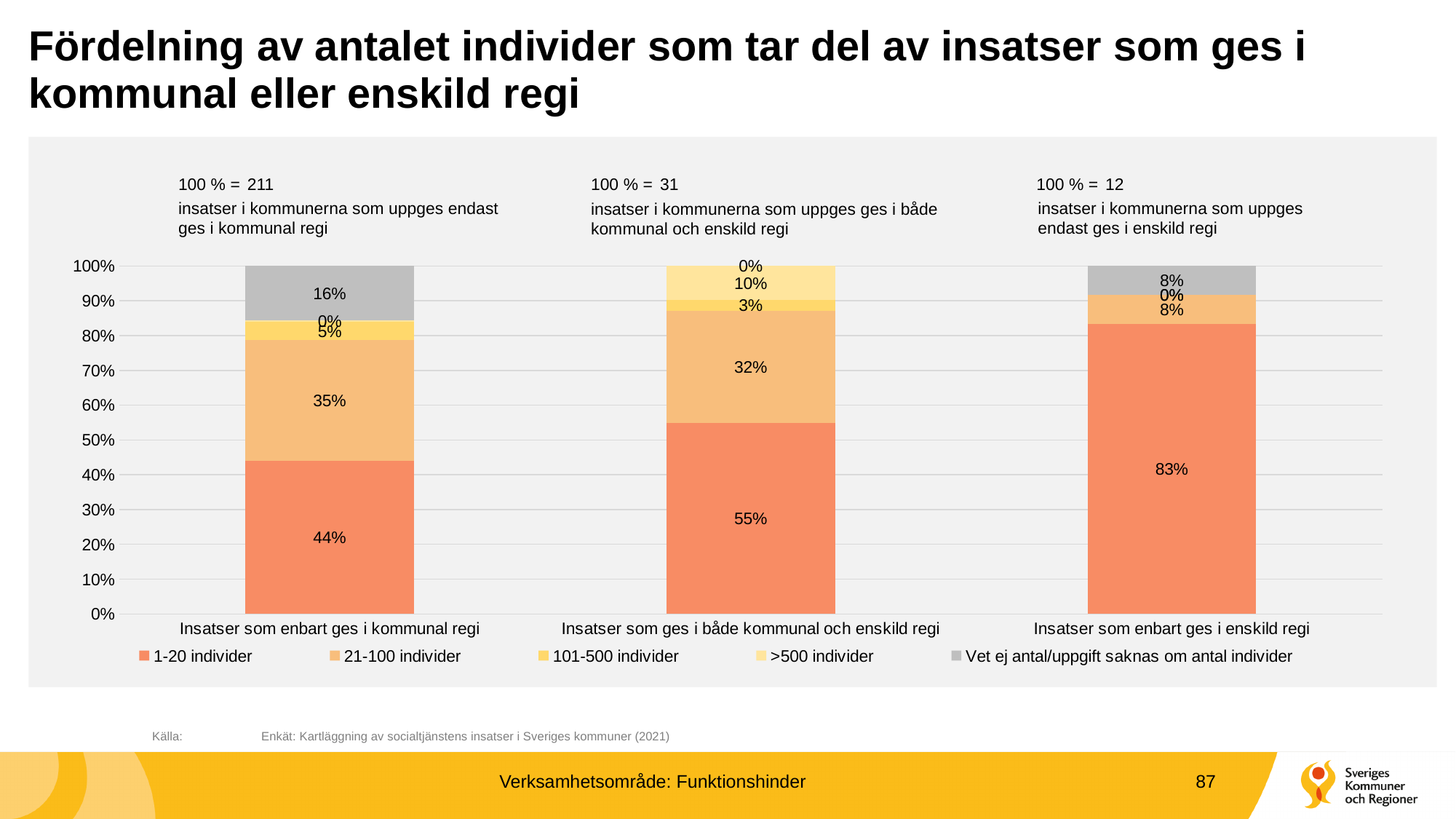
Which has the larger share for "21-100 individer": "Insatser som enbart ges i kommunal regi" or "Insatser som ges i både kommunal och enskild regi"? Insatser som enbart ges i kommunal regi Which category has the highest share for "1-20 individer"? Insatser som enbart ges i enskild regi What is the value for "1-20 individer" in the bar "Insatser som enbart ges i enskild regi"? 83% What is the value for "1-20 individer" in the bar "Insatser som enbart ges i kommunal regi"? 44% How many categories (bars) are shown on the x axis? 3 How many series does the legend list? 5 What is the value for "21-100 individer" in the bar "Insatser som ges i både kommunal och enskild regi"? 32% What is the value for ">500 individer" in the bar "Insatser som ges i både kommunal och enskild regi"? 10% What is the value for "Vet ej antal/uppgift saknas om antal individer" in the bar "Insatser som enbart ges i kommunal regi"? 16% What kind of chart is shown on the slide? Stacked bar chart According to the note above the first bar, how many insatser does 100% correspond to for insatser that are only given in kommunal regi? 211 What is the difference in the "1-20 individer" share between "Insatser som enbart ges i enskild regi" and "Insatser som enbart ges i kommunal regi"? 39 percentage points